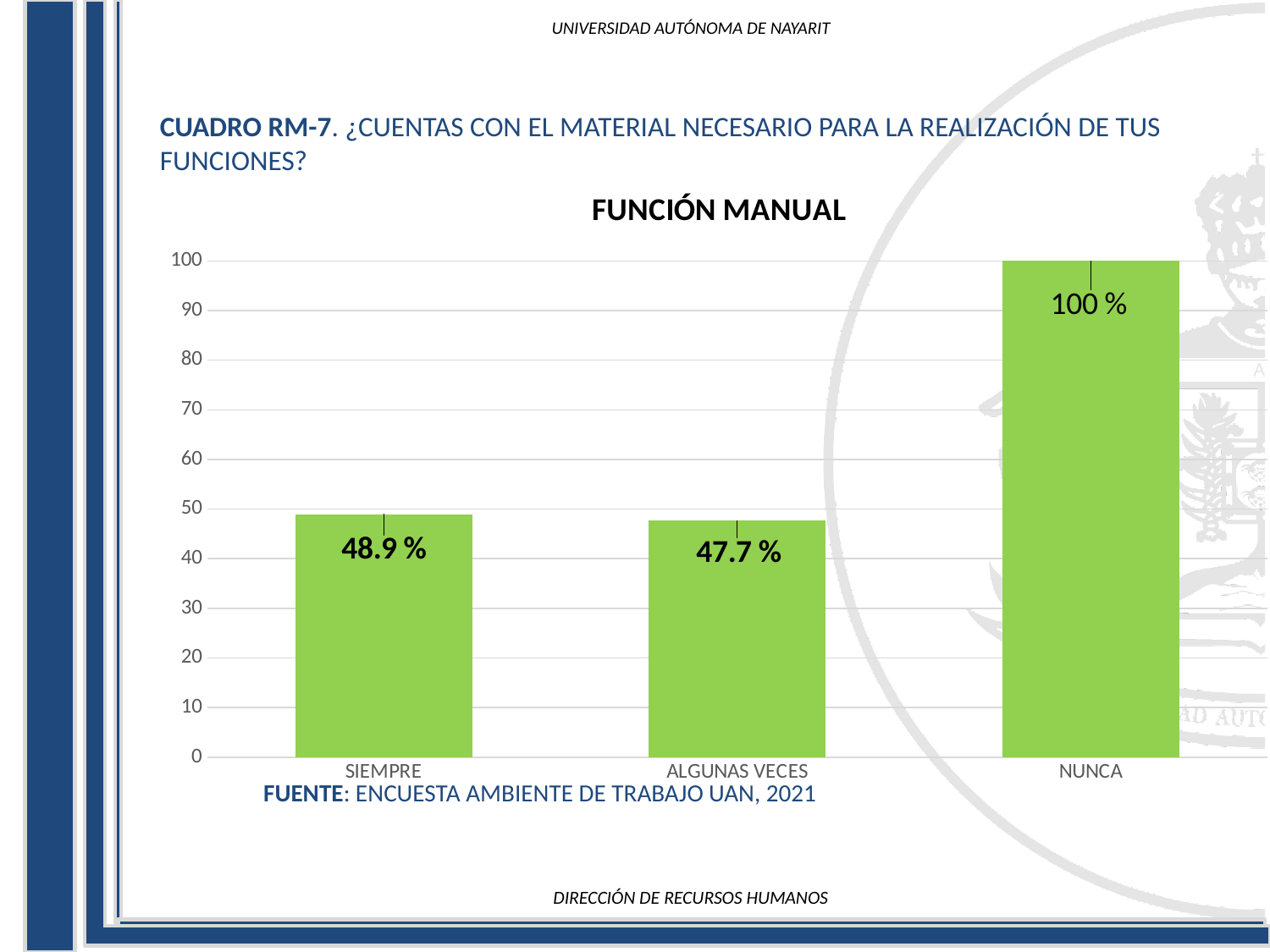
What is the value for NUNCA in the FUNCIÓN MANUAL chart? 100 % What is the title of the chart on the slide? FUNCIÓN MANUAL What is the difference between the values for SIEMPRE and ALGUNAS VECES in the FUNCIÓN MANUAL chart? 1.2 % Which is larger in the FUNCIÓN MANUAL chart, the value for NUNCA or the value for ALGUNAS VECES? NUNCA Which category has the lowest value in the FUNCIÓN MANUAL chart? ALGUNAS VECES What kind of chart is the FUNCIÓN MANUAL chart? bar chart What is the value for ALGUNAS VECES in the FUNCIÓN MANUAL chart? 47.7 % What is the difference between the values for NUNCA and SIEMPRE in the FUNCIÓN MANUAL chart? 51.1 % How many categories are shown in the FUNCIÓN MANUAL chart? 3 Is the value for SIEMPRE in the FUNCIÓN MANUAL chart greater or less than 50? less What is the value for SIEMPRE in the FUNCIÓN MANUAL chart? 48.9 % Which category has the highest value in the FUNCIÓN MANUAL chart? NUNCA